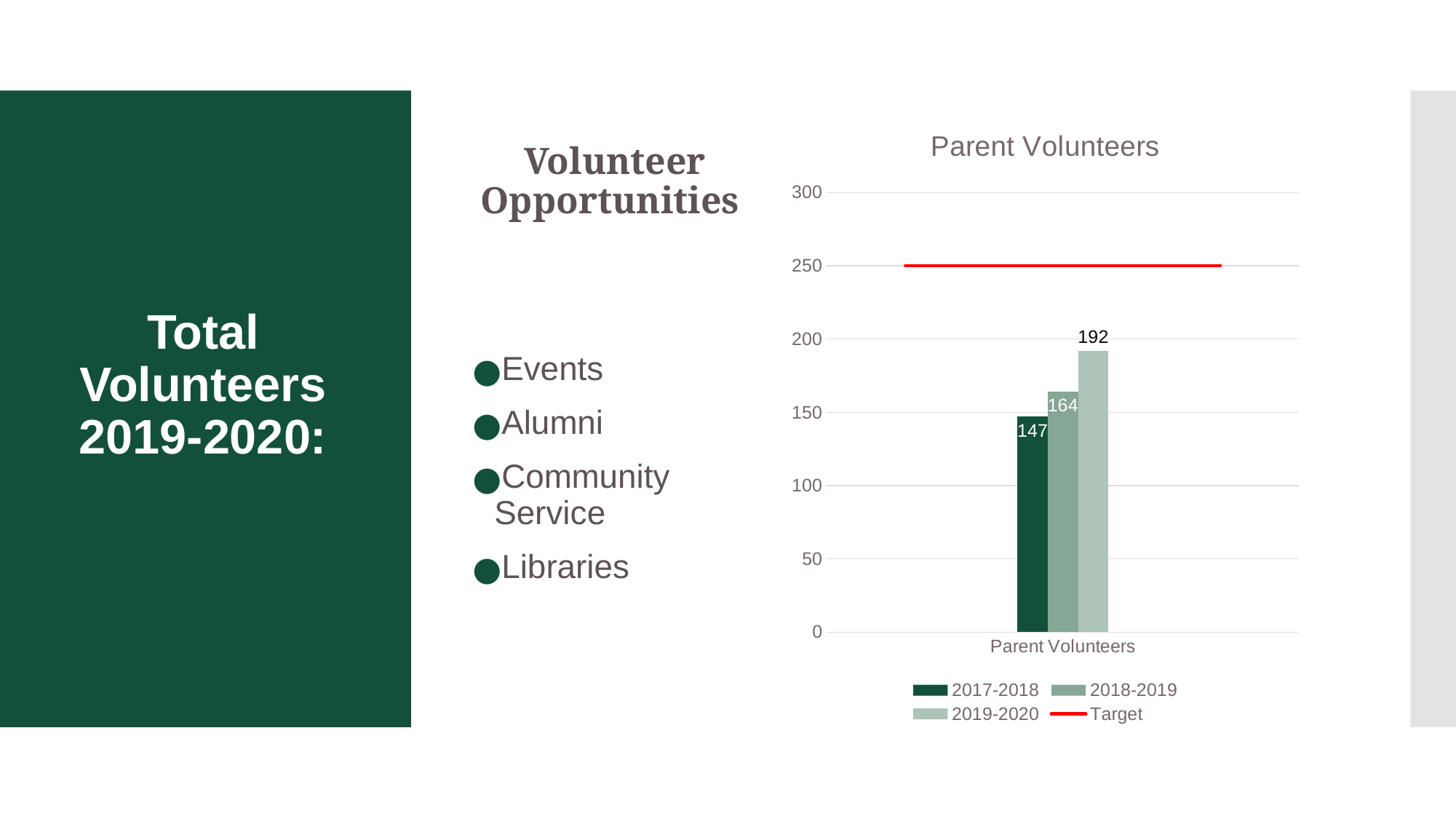
What kind of chart is shown on the slide? combination bar and line chart What is the value for 2019-2020 in the Parent Volunteers chart? 192 Which series has the lowest value in the Parent Volunteers chart? 2017-2018 Is the Target line greater or less than 200? greater Which is larger, the value for 2018-2019 or the value for 2019-2020? 2019-2020 What is the difference between the 2019-2020 and 2017-2018 values? 45 What is the difference between the 2018-2019 and 2017-2018 values? 17 What is the value for 2018-2019 in the Parent Volunteers chart? 164 How many entries does the legend list? 4 What is the title of the chart? Parent Volunteers Which series has the highest value in the Parent Volunteers chart? Target What is the value for 2017-2018 in the Parent Volunteers chart? 147